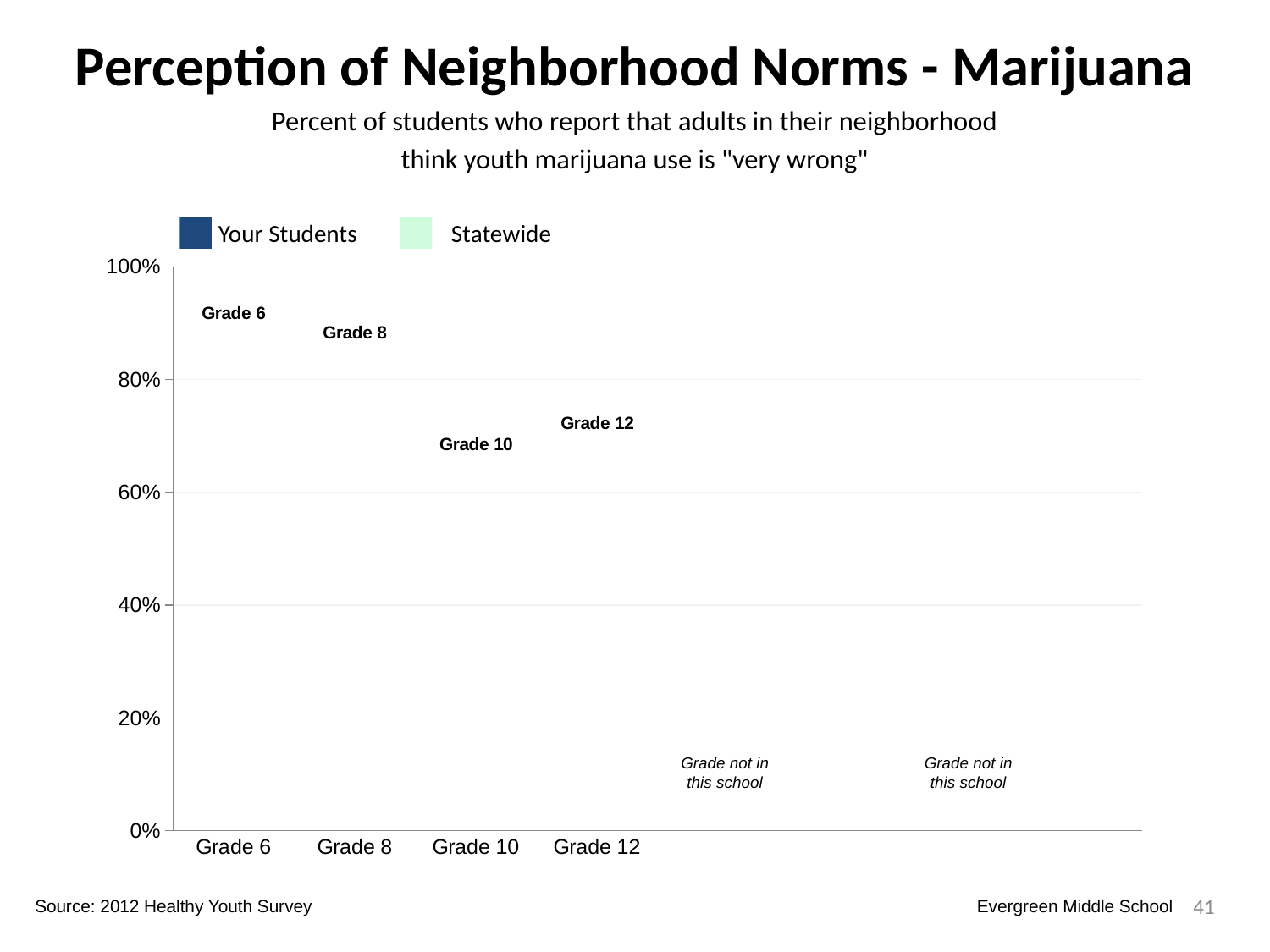
What are the two series named in the legend? Your Students and Statewide What is the title of the chart? Perception of Neighborhood Norms - Marijuana What is the lowest value shown on the y axis? 0% How many series does the legend list? 2 What is the highest value shown on the y axis? 100% How many grade categories are labeled along the x axis? 4